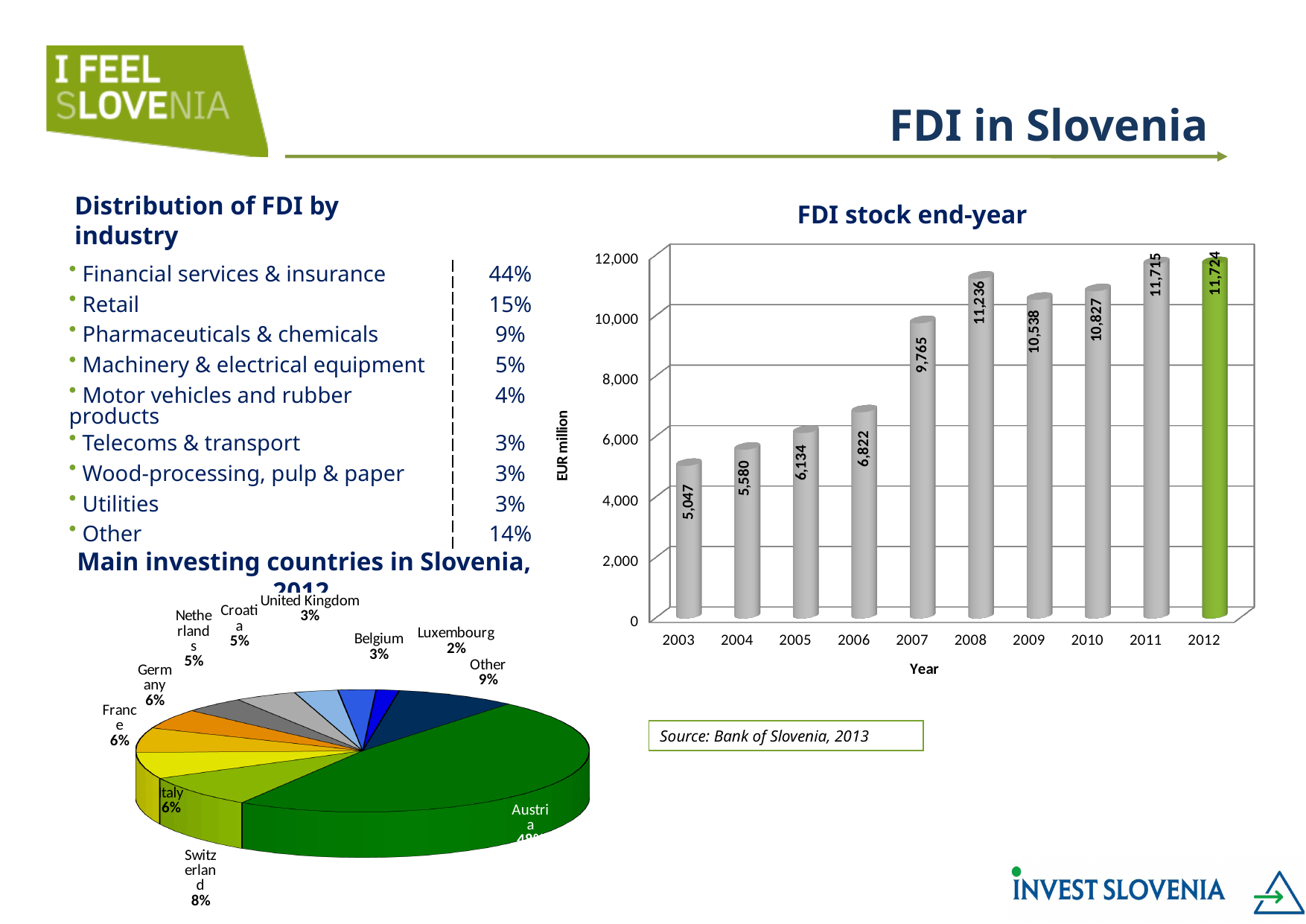
In the 'FDI stock end-year' chart, what is the label on the vertical axis? EUR million In the 'FDI stock end-year' chart, what is the difference between the 2012 and 2003 values? 6,677 What kind of chart is the 'FDI stock end-year' chart? Bar chart In the 'FDI stock end-year' chart, do the values rise or fall from 2003 to 2008? Rise In the 'FDI stock end-year' chart, how many years are shown on the x axis? 10 In the 'FDI stock end-year' chart, what is the value for 2004? 5,580 In the 'FDI stock end-year' chart, which year has the lowest FDI stock? 2003 In the 'FDI stock end-year' chart, which year has the larger value, 2009 or 2010? 2010 In the 'Main investing countries in Slovenia, 2012' pie chart, what share does Switzerland have? 8% In the 'FDI stock end-year' chart, which year has the highest FDI stock? 2012 In the 'Main investing countries in Slovenia, 2012' pie chart, which country has the largest slice? Austria In the 'FDI stock end-year' chart, what is the value for 2007? 9,765